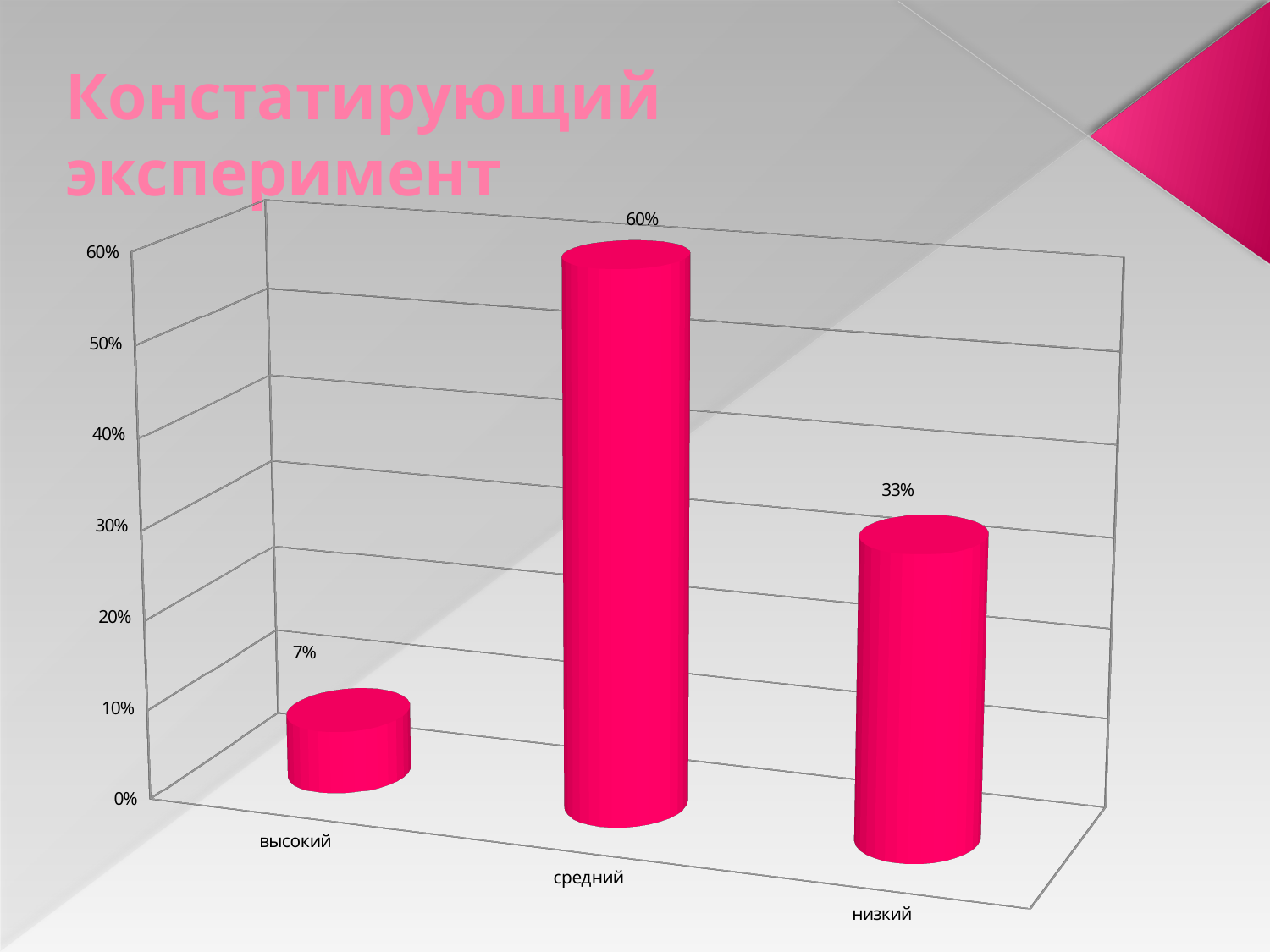
What kind of chart is shown on the slide? bar chart What is the value for низкий? 33% Which is larger, the value for низкий or the value for высокий? низкий What is the value for средний? 60% What is the difference between the values for средний and низкий? 27% What is the title of the slide? Констатирующий эксперимент What is the value for высокий? 7% What is the difference between the values for низкий and высокий? 26% Is the value for низкий greater or less than 30%? greater How many categories are shown on the chart? 3 Which category has the highest value? средний Which category has the lowest value? высокий